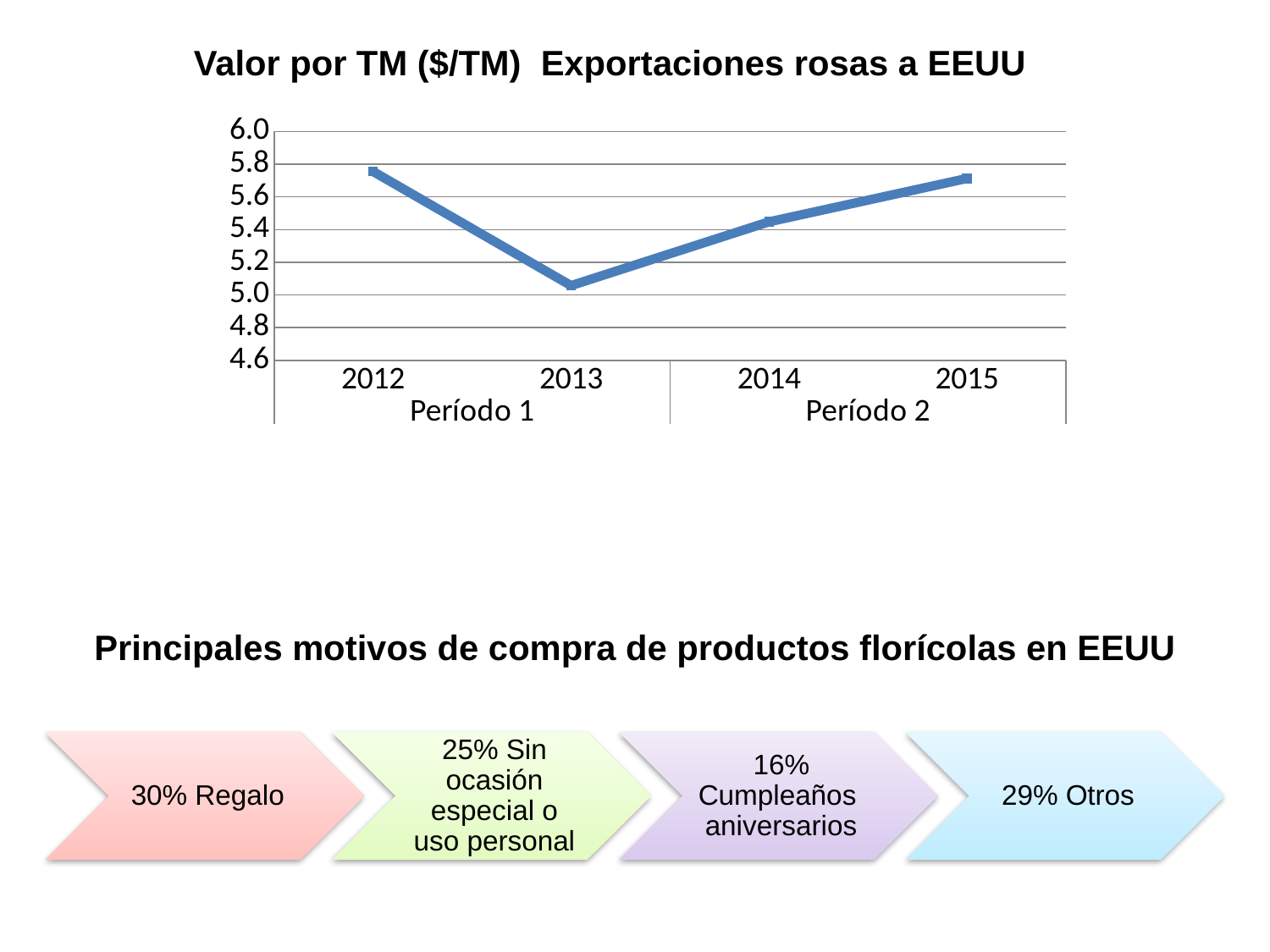
What is the title of the line chart? Valor por TM ($/TM) Exportaciones rosas a EEUU Is the value for 2013 greater or less than 5.2? less Is the value for 2012 greater or less than 5.6? greater Which year has the larger value per TM, 2013 or 2014? 2014 Is the value for 2015 greater or less than 5.6? greater Into how many periods are the years grouped on the x axis of the line chart? 2 What kind of chart is shown on the slide? line chart Does the value per TM rise or fall from 2013 to 2015? rise How many years are plotted on the line chart? 4 Which year has the lowest value per TM on the line chart? 2013 Which year has the larger value per TM, 2012 or 2013? 2012